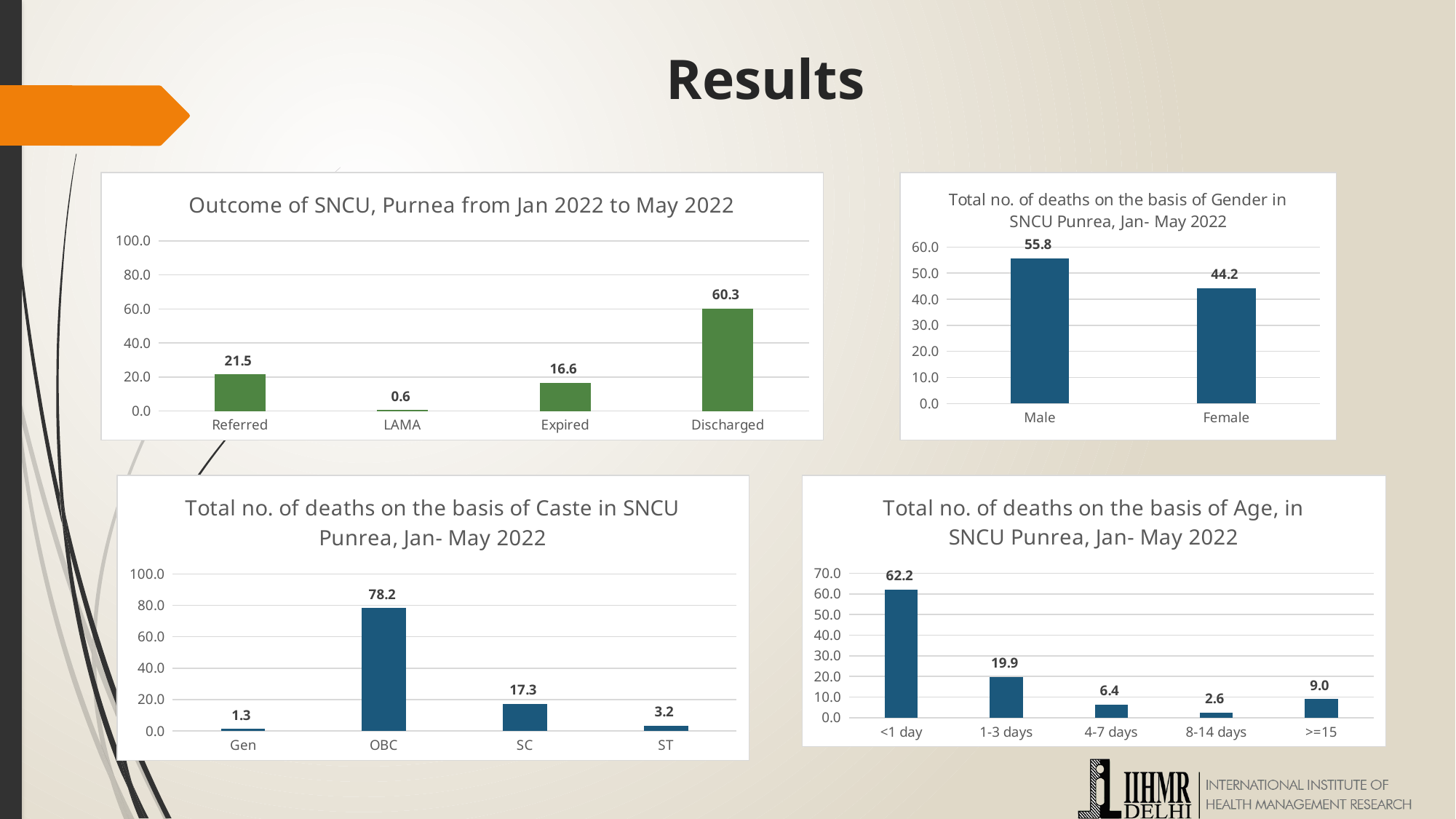
How many categories are shown in the chart 'Total no. of deaths on the basis of Age, in SNCU Punrea, Jan- May 2022'? 5 How many categories are shown in the chart 'Total no. of deaths on the basis of Caste in SNCU Punrea, Jan- May 2022'? 4 In the chart 'Total no. of deaths on the basis of Age, in SNCU Punrea, Jan- May 2022', what is the value for 1-3 days? 19.9 In the chart 'Total no. of deaths on the basis of Age, in SNCU Punrea, Jan- May 2022', which category has the lowest value? 8-14 days In the chart 'Total no. of deaths on the basis of Caste in SNCU Punrea, Jan- May 2022', which category has the highest value? OBC In the chart 'Total no. of deaths on the basis of Caste in SNCU Punrea, Jan- May 2022', what is the value for SC? 17.3 What kind of chart is 'Total no. of deaths on the basis of Gender in SNCU Punrea, Jan- May 2022'? Bar chart In the chart 'Outcome of SNCU, Purnea from Jan 2022 to May 2022', what is the difference between the values for Referred and Expired? 4.9 In the chart 'Outcome of SNCU, Purnea from Jan 2022 to May 2022', what is the value for Discharged? 60.3 In the chart 'Outcome of SNCU, Purnea from Jan 2022 to May 2022', which category has the lowest value? LAMA In the chart 'Total no. of deaths on the basis of Gender in SNCU Punrea, Jan- May 2022', what is the value for Female? 44.2 In the chart 'Total no. of deaths on the basis of Gender in SNCU Punrea, Jan- May 2022', which is larger, Male or Female? Male